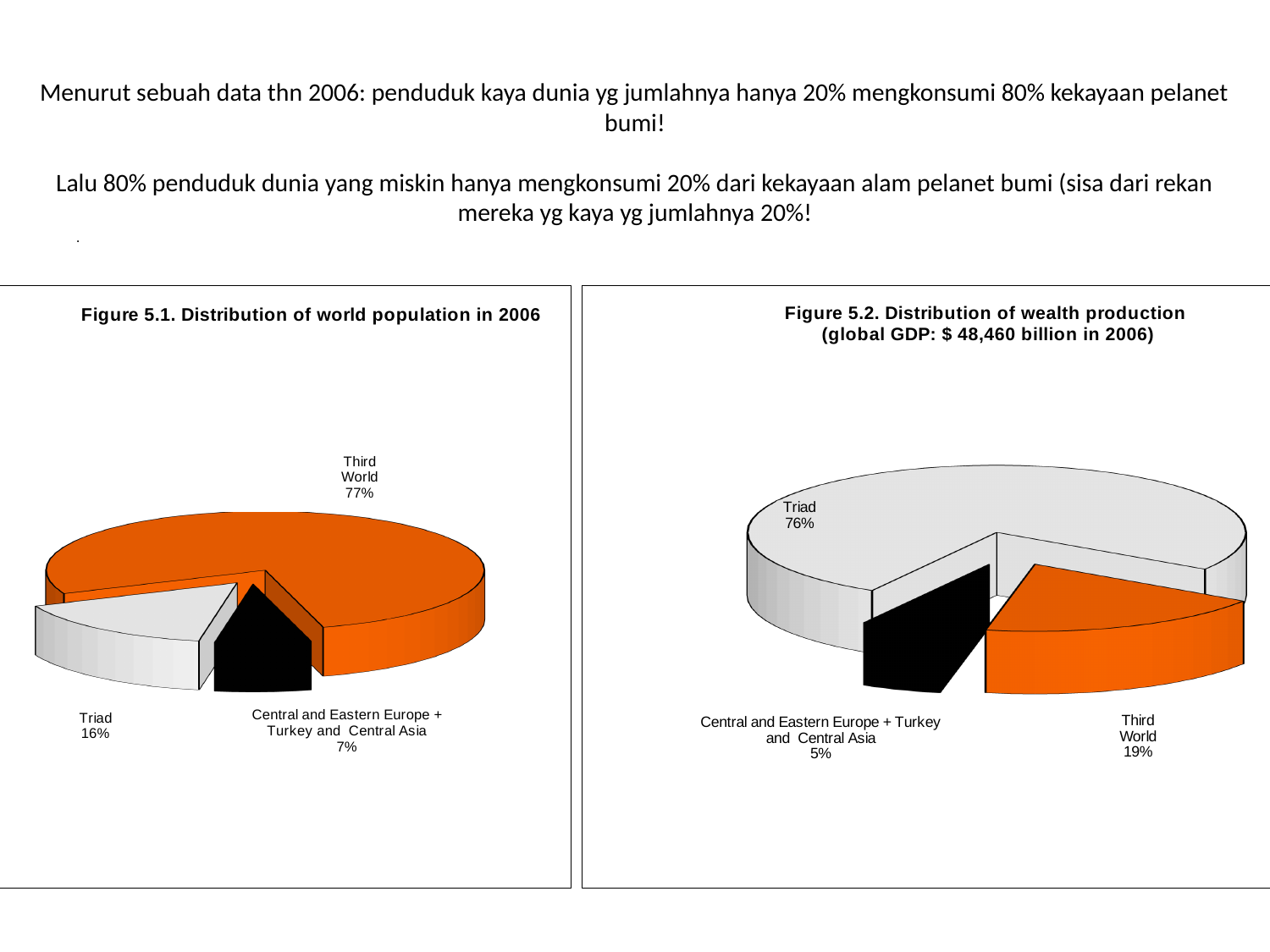
In Figure 5.2 (Distribution of wealth production), what share does the Third World hold? 19% In Figure 5.1 (Distribution of world population in 2006), what is the difference between the Third World share and the Triad share? 61 percentage points In Figure 5.1 (Distribution of world population in 2006), what share of world population is the Third World? 77% In Figure 5.2 (Distribution of wealth production), which region has the smallest slice? Central and Eastern Europe + Turkey and Central Asia In Figure 5.1 (Distribution of world population in 2006), what share is Central and Eastern Europe + Turkey and Central Asia? 7% In Figure 5.1 (Distribution of world population in 2006), which region has the largest slice? Third World What type of chart is Figure 5.2 (Distribution of wealth production)? Pie chart In Figure 5.2 (Distribution of wealth production), what share does the Triad hold? 76% In Figure 5.1 (Distribution of world population in 2006), what share is the Triad? 16% In Figure 5.2 (Distribution of wealth production), what share does Central and Eastern Europe + Turkey and Central Asia hold? 5% How many slices does the pie in Figure 5.1 (Distribution of world population in 2006) have? 3 In Figure 5.2 (Distribution of wealth production), which is larger, the Triad share or the Third World share? Triad